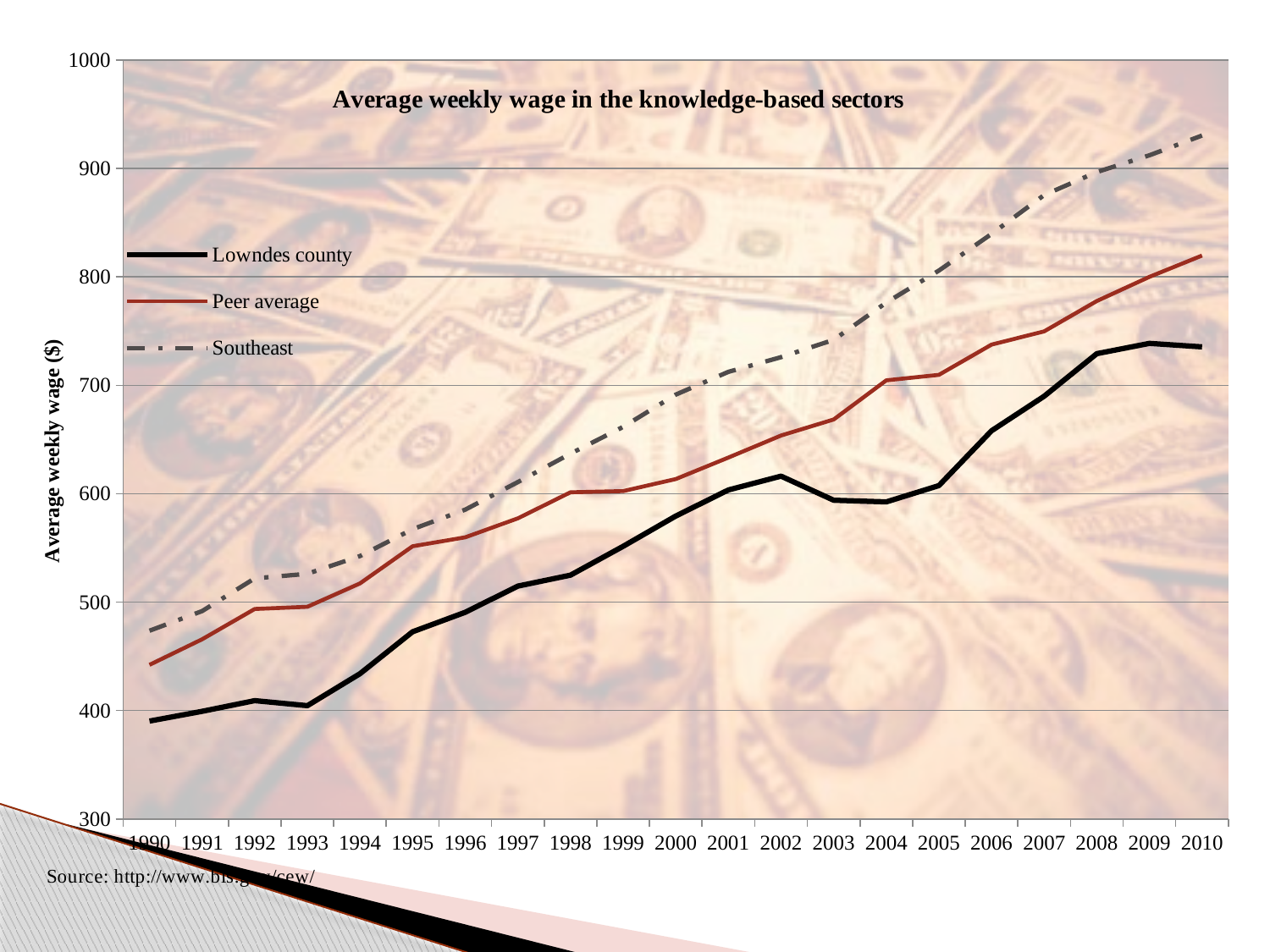
In which year is the Southeast value highest? 2010 Which series has the highest value in 2010? Southeast How many series does the legend list? 3 In 1990, which is larger: the Peer average value or the Lowndes county value? Peer average In which year is the Lowndes county value lowest? 1990 What kind of chart is shown on the slide? line chart Is the value for Southeast in 2010 greater or less than 900? greater What is the title of the chart? Average weekly wage in the knowledge-based sectors Is the value for Lowndes county in 1990 greater or less than 400? less Is the value for Peer average in 2010 greater or less than 800? greater How many years are plotted along the x axis? 21 Does the Southeast series generally rise or fall from 1990 to 2010? rise